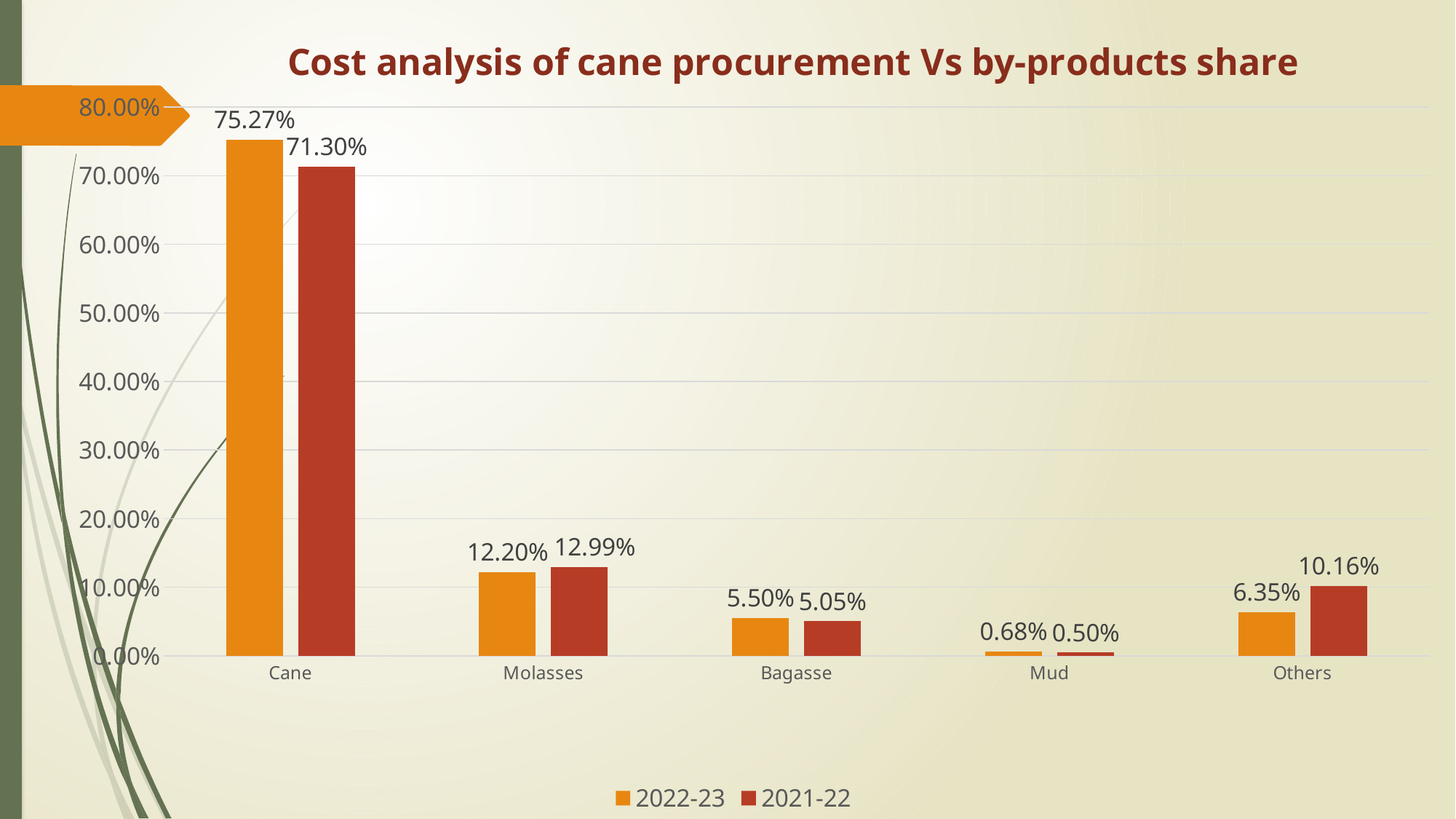
What kind of chart is shown on the slide? Bar chart Which category has the highest value in the 2021-22 series? Cane What is the difference between the 2021-22 and 2022-23 values for Others? 3.81% What is the difference between the 2022-23 and 2021-22 values for Cane? 3.97% How many categories are shown on the x axis? 5 What is the value for Cane in the 2022-23 series? 75.27% Is the 2021-22 value for Cane greater or less than 70.00%? greater What is the value for Others in the 2021-22 series? 10.16% Which is larger for Molasses: the 2022-23 value or the 2021-22 value? 2021-22 What is the value for Mud in the 2022-23 series? 0.68% Which category has the lowest value in the 2022-23 series? Mud How many series does the legend list? 2